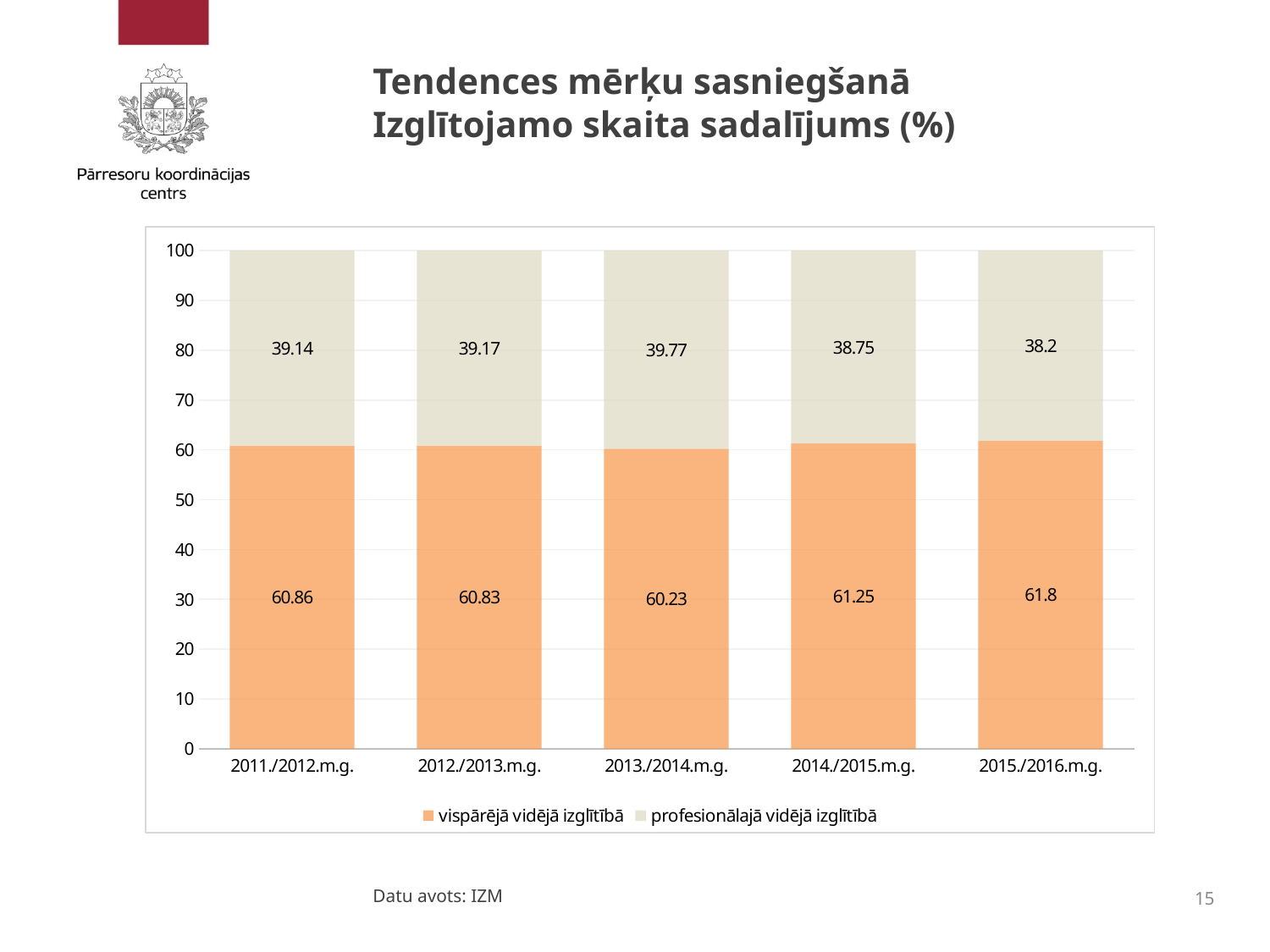
What is the value for profesionālajā vidējā izglītībā in 2011./2012.m.g.? 39.14 What is the total of the stacked bar for 2014./2015.m.g.? 100 Which series is shown in orange in the legend? vispārējā vidējā izglītībā What is the difference between the vispārējā vidējā izglītībā values for 2015./2016.m.g. and 2013./2014.m.g.? 1.57 How many series does the legend list? 2 What kind of chart is shown on the slide? Stacked bar chart How many school years are shown on the x axis? 5 What is the value for profesionālajā vidējā izglītībā in 2015./2016.m.g.? 38.2 Which school year has the lowest value for profesionālajā vidējā izglītībā? 2015./2016.m.g. Which school year has the highest value for vispārējā vidējā izglītībā? 2015./2016.m.g. What is the value for vispārējā vidējā izglītībā in 2013./2014.m.g.? 60.23 Which is larger: the profesionālajā vidējā izglītībā value in 2013./2014.m.g. or in 2014./2015.m.g.? 2013./2014.m.g.